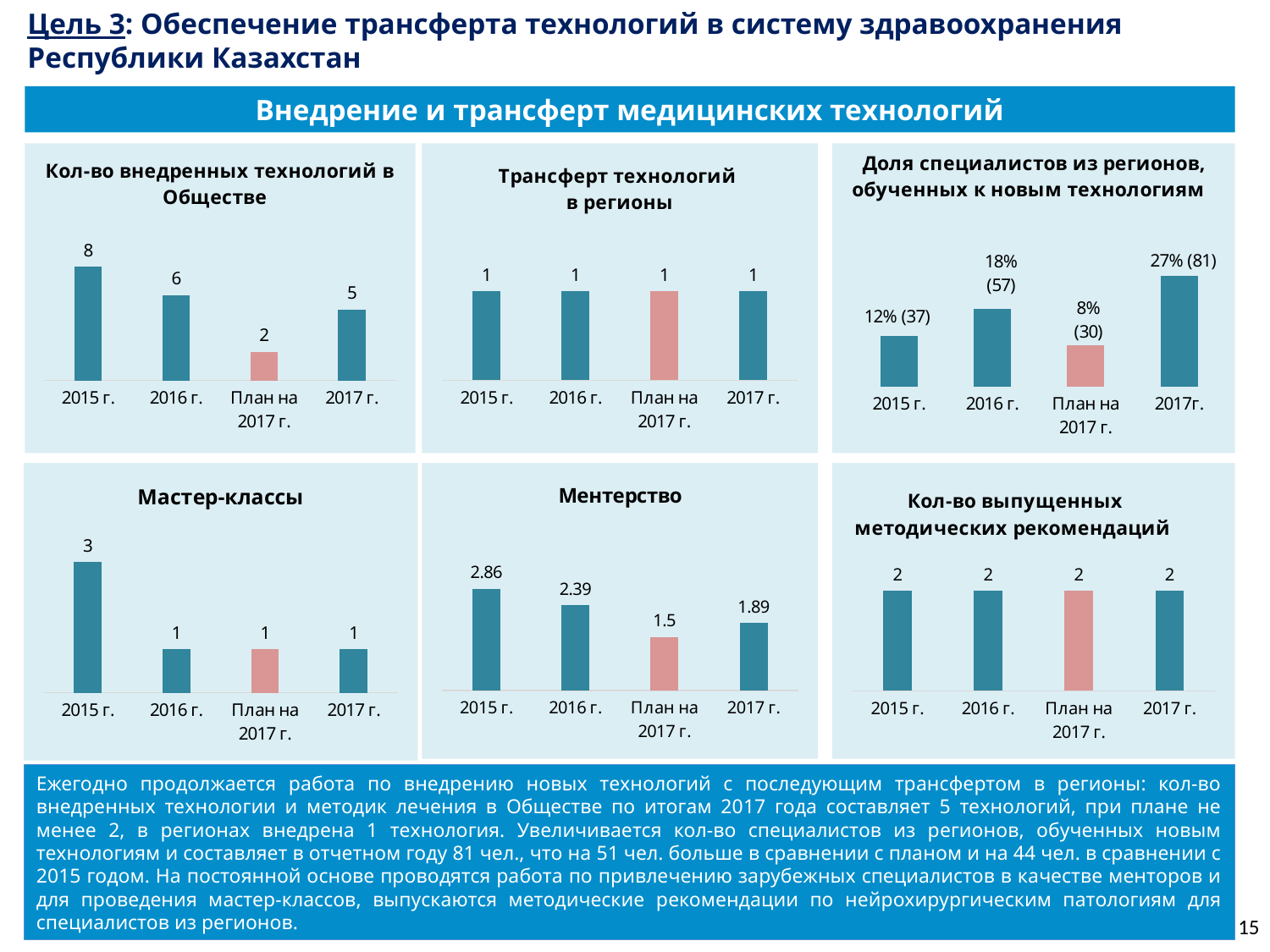
In the chart 'Кол-во внедренных технологий в Обществе', what is the value for 2015 г.? 8 What type of chart is 'Менторство'? Bar chart In the chart 'Мастер-классы', how many categories are shown on the x axis? 4 In the chart 'Трансферт технологий в регионы', what is the value for 2017 г.? 1 In the chart 'Доля специалистов из регионов, обученных к новым технологиям', which category has the highest value? 2017г. In the chart 'Доля специалистов из регионов, обученных к новым технологиям', what is the label shown for 2017г.? 27% (81) In the chart 'Кол-во внедренных технологий в Обществе', which category has the lowest value? План на 2017 г. In the chart 'Кол-во выпущенных методических рекомендаций', what is the value for План на 2017 г.? 2 In the chart 'Мастер-классы', what is the value for 2015 г.? 3 In the chart 'Кол-во внедренных технологий в Обществе', what is the difference between the values for 2015 г. and 2017 г.? 3 In the chart 'Менторство', which is larger: the value for План на 2017 г. or the value for 2017 г.? 2017 г. In the chart 'Менторство', what is the value for 2016 г.? 2.39